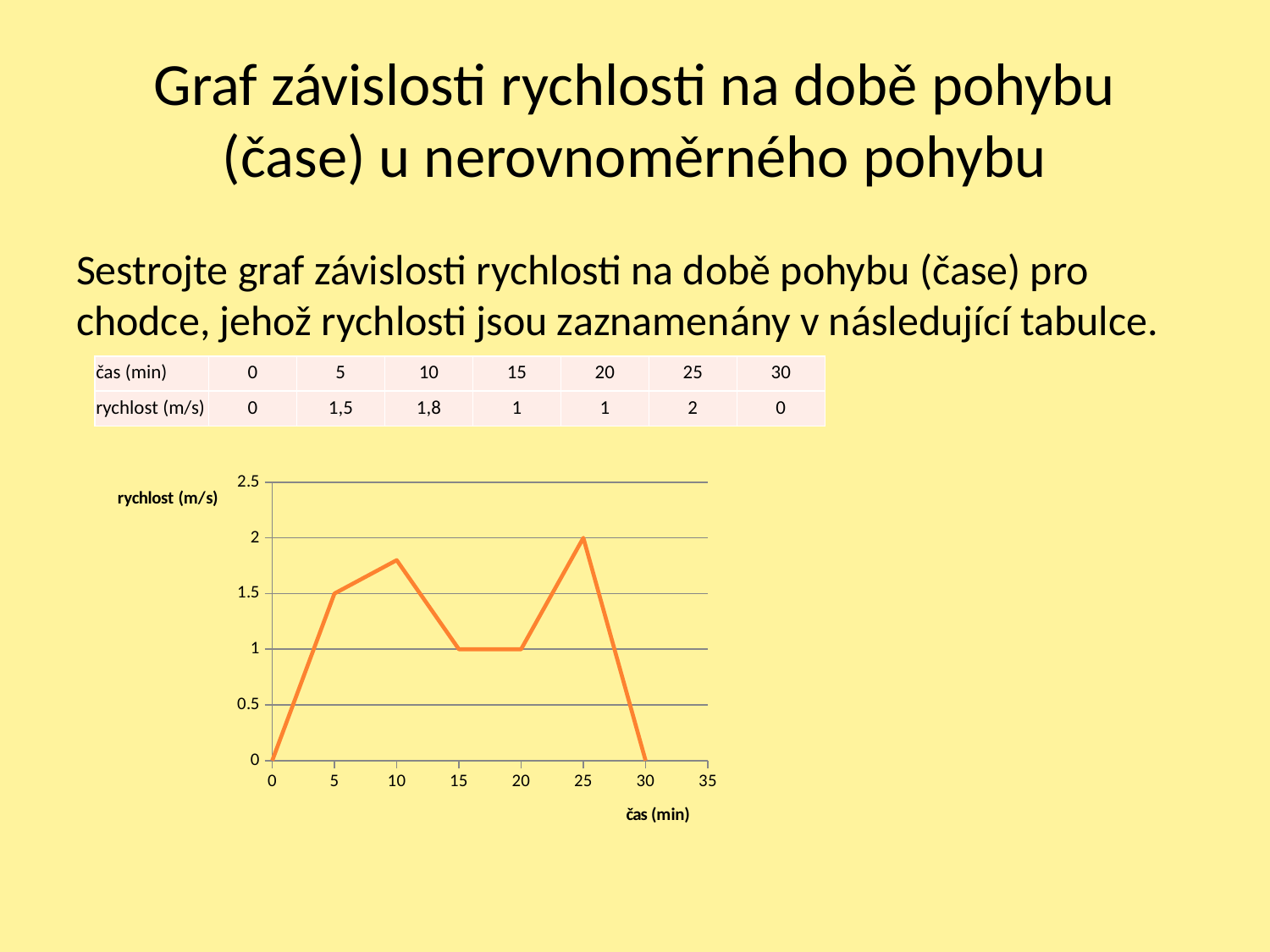
How many data points are plotted on the line? 7 What is the speed (rychlost) at time 25 min? 2 At which time (čas) is the speed highest? 25 Is the speed at 10 min greater or less than 1.5? greater Does the speed rise or fall between 25 min and 30 min? fall Which is larger, the speed at 10 min or the speed at 20 min? 10 min What is the label of the horizontal axis? čas (min) What is the speed (rychlost) at time 10 min? 1,8 What is the label of the vertical axis? rychlost (m/s) What is the difference between the speed at 25 min and the speed at 15 min? 1 What is the speed (rychlost) at time 5 min? 1,5 What kind of chart is shown on the slide? line chart